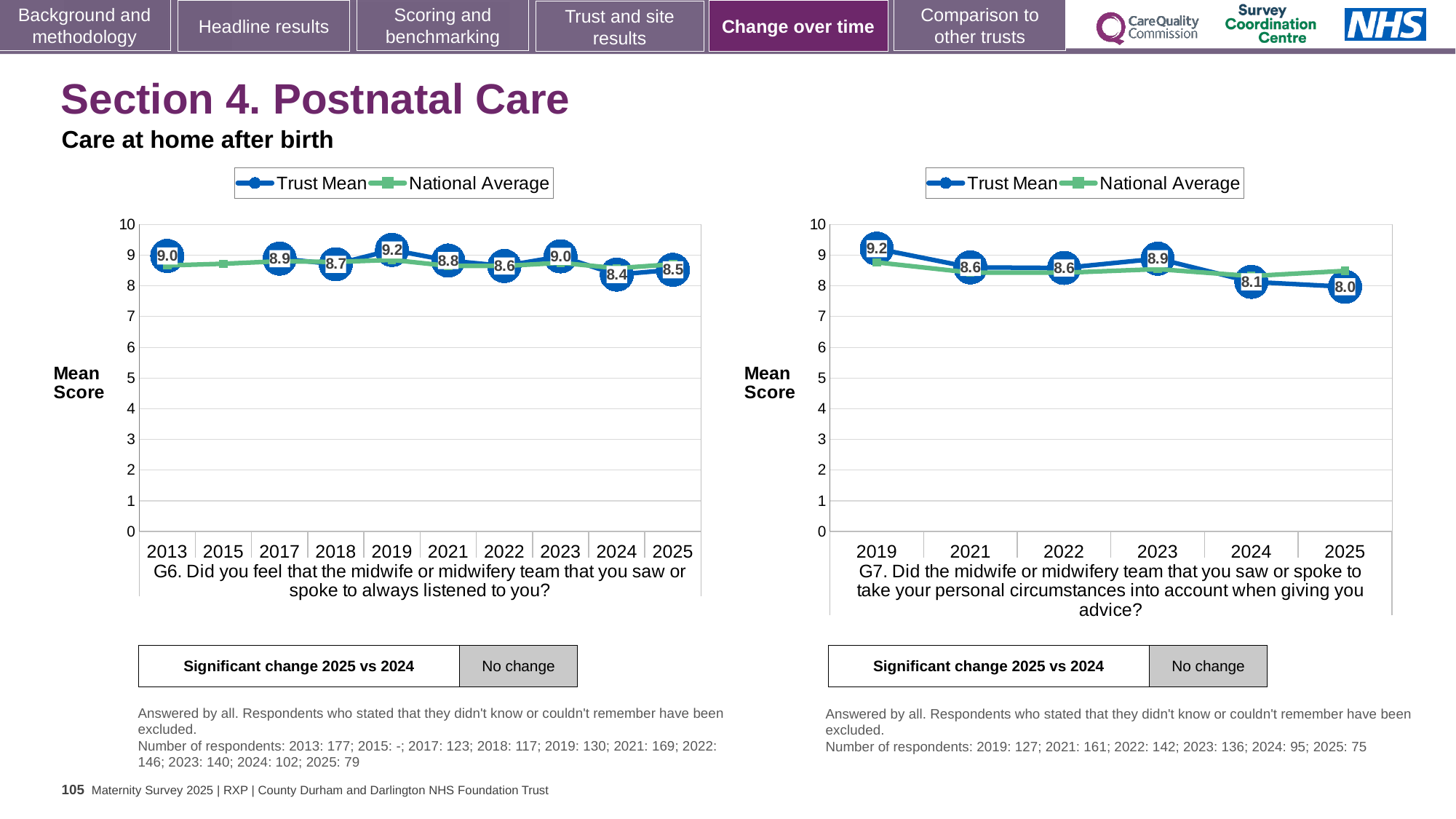
In the left chart (G6), which year has the lowest Trust Mean score? 2024 How many series does the legend of the left chart (G6) list? 2 In the right chart (G7), what is the difference between the Trust Mean scores for 2019 and 2025? 1.2 In the left chart (G6), what is the difference between the Trust Mean scores for 2019 and 2024? 0.8 In the left chart (G6), what is the Trust Mean score for 2025? 8.5 In the right chart (G7), what is the Trust Mean score for 2024? 8.1 How many years are shown on the x axis of the right chart (G7)? 6 In the right chart (G7), is the National Average value for 2025 greater or less than 8? greater In the right chart (G7), which year has the highest Trust Mean score? 2019 In the left chart (G6), is the Trust Mean score higher in 2023 or in 2022? 2023 In the left chart (G6), what is the Trust Mean score for 2019? 9.2 What type of chart is the right chart (G7)? Line chart